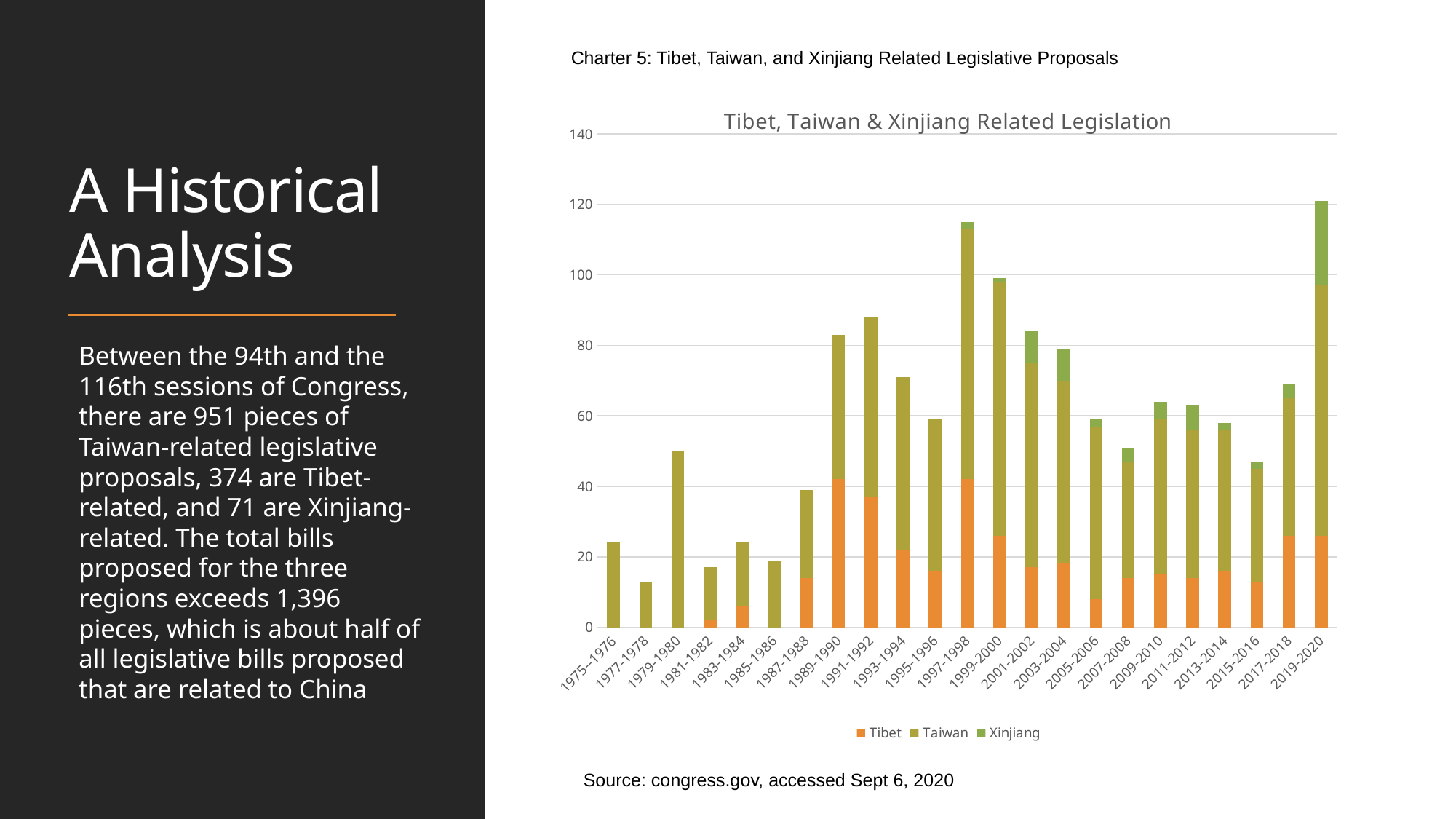
Which session period has the lowest total bar in the chart? 1977-1978 Which has the larger total bar, 1997-1998 or 1999-2000? 1997-1998 How many series does the chart's legend list? 3 Is the total value for 1989-1990 greater or less than 80? greater Is the total value for 1993-1994 greater or less than 60? greater Which series is shown in orange in the chart? Tibet What is the title printed inside the chart area? Tibet, Taiwan & Xinjiang Related Legislation What kind of chart is shown on the slide? Stacked bar chart How many congressional session periods are shown along the x axis of the chart? 23 Is the total value for 2015-2016 greater or less than 60? less Which session period has the highest total bar in the chart? 2019-2020